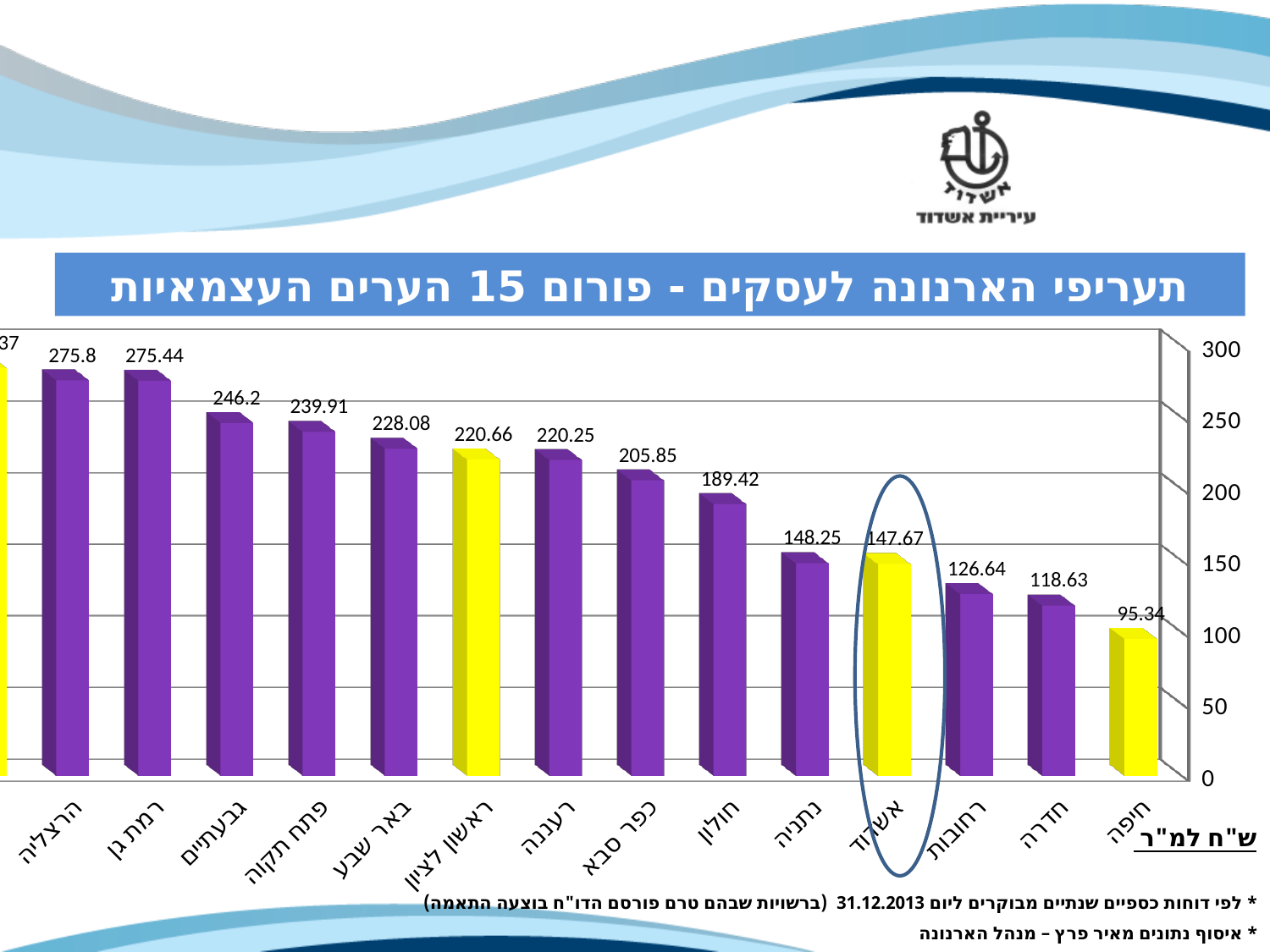
Which city's bar is circled on the chart? אשדוד Do the values rise or fall from left to right along the x axis? fall What kind of chart is shown on the slide? bar chart What is the value for אשדוד? 147.67 What is the value for ראשון לציון? 220.66 What is the value for חדרה? 118.63 Which is larger, the value for חולון or the value for רחובות? חולון Which city has the lowest value? חיפה What is the value for כפר סבא? 205.85 Is the value for רחובות greater or less than 150? less What is the difference between the values for אשדוד and חיפה? 52.33 What is the value for חיפה? 95.34